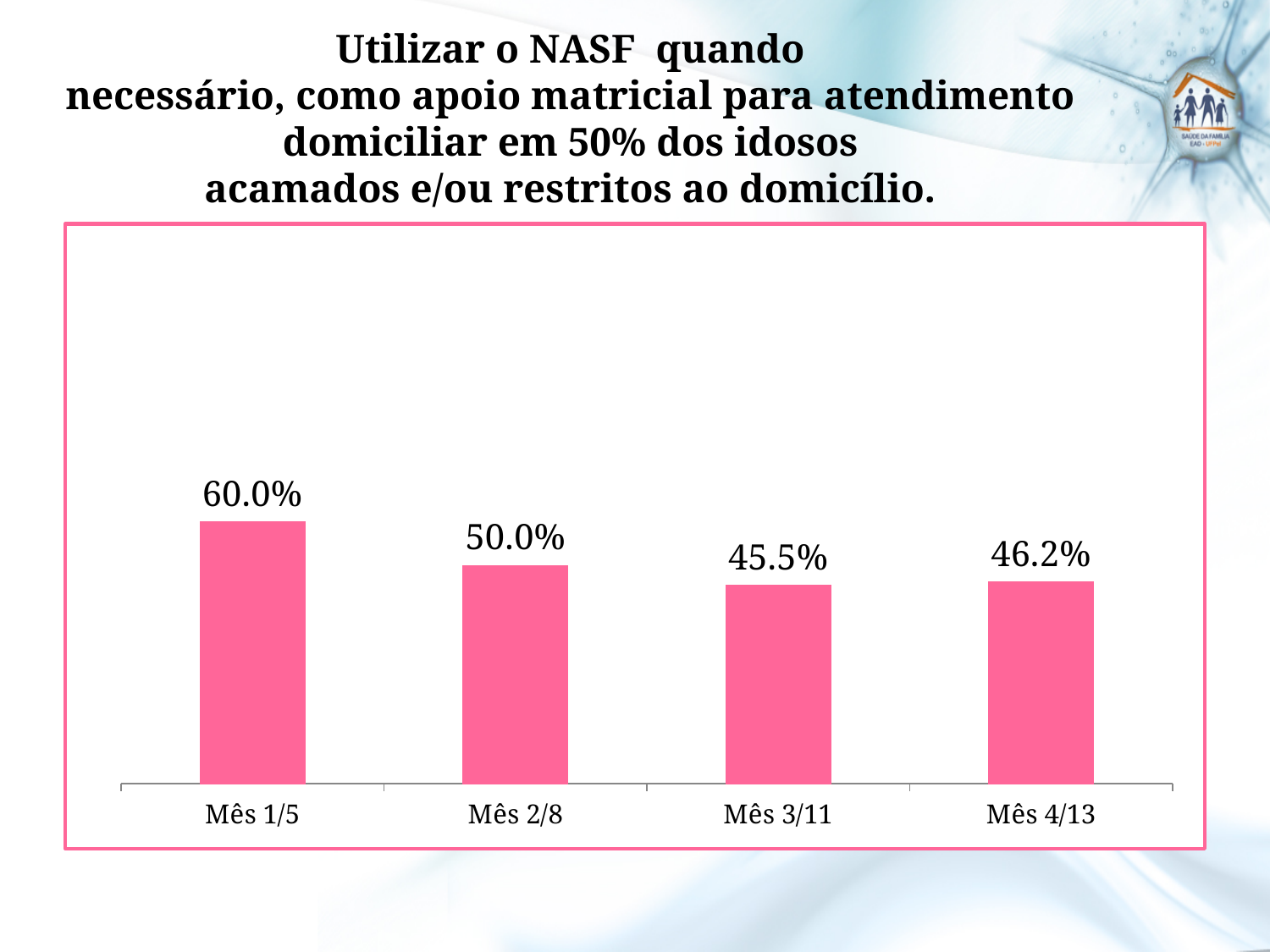
Do the values rise or fall from Mês 1/5 to Mês 3/11? Fall What is the value for Mês 1/5? 60.0% What is the value for Mês 2/8? 50.0% What is the difference between the values for Mês 1/5 and Mês 2/8? 10.0% Which category has the lowest value? Mês 3/11 What is the difference between the values for Mês 4/13 and Mês 3/11? 0.7% What is the value for Mês 3/11? 45.5% What kind of chart is shown on the slide? Bar chart Which is larger, the value for Mês 2/8 or the value for Mês 4/13? Mês 2/8 How many categories are shown on the x axis? 4 Which category has the highest value? Mês 1/5 What is the value for Mês 4/13? 46.2%